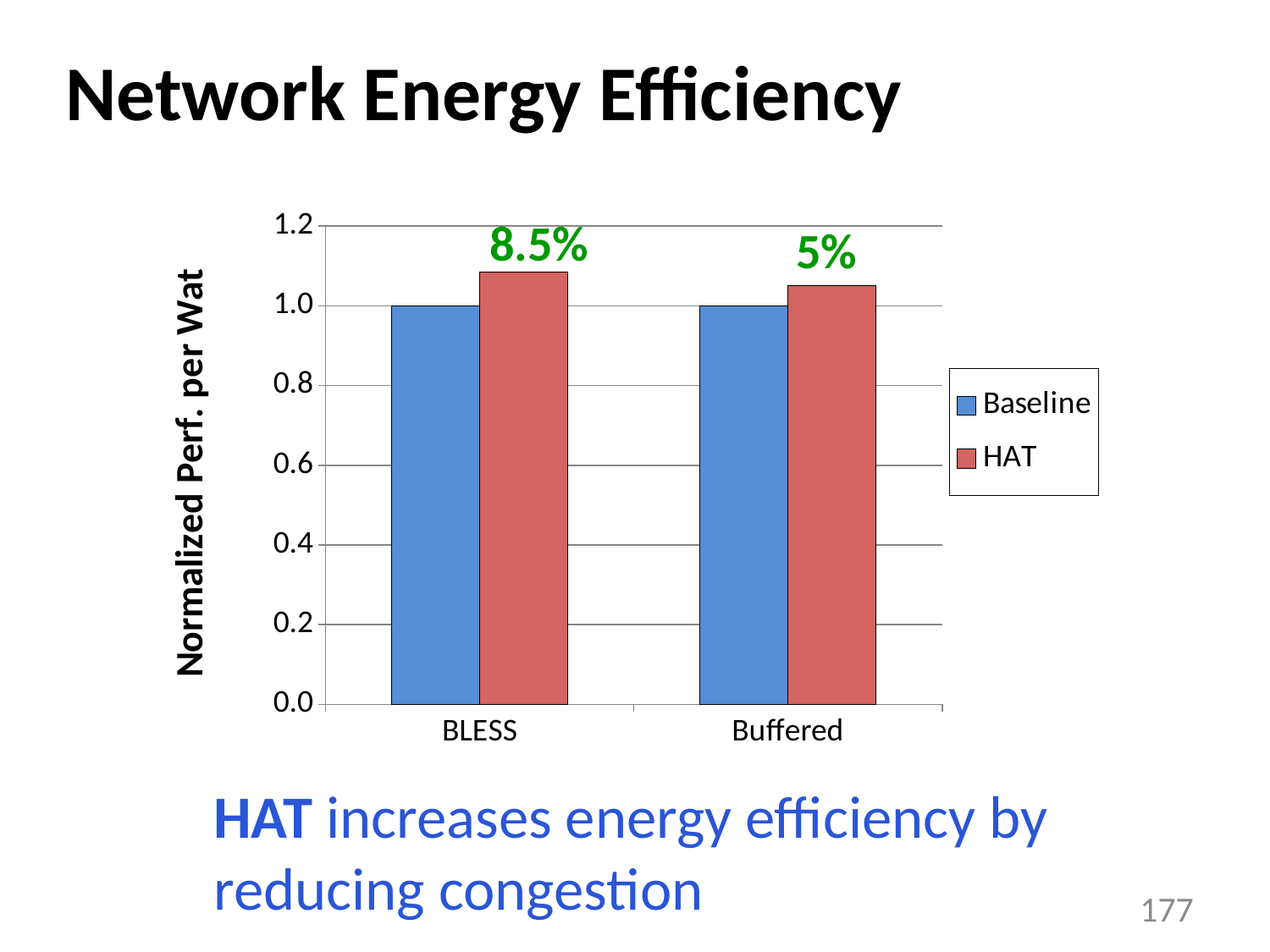
For BLESS, which series has the larger value, Baseline or HAT? HAT What is the title of the y axis? Normalized Perf. per Wat How many series does the legend list? 2 Is the HAT value for BLESS greater or less than 1.0? greater Which series has the lowest bar for Buffered? Baseline How many categories are shown on the x axis? 2 Is the HAT value for Buffered greater or less than 1.2? less What is the Baseline value for BLESS? 1.0 What percentage improvement is annotated above the BLESS bars? 8.5% What kind of chart is shown on the slide? bar chart What is the Baseline value for Buffered? 1.0 Which category has the higher HAT value, BLESS or Buffered? BLESS